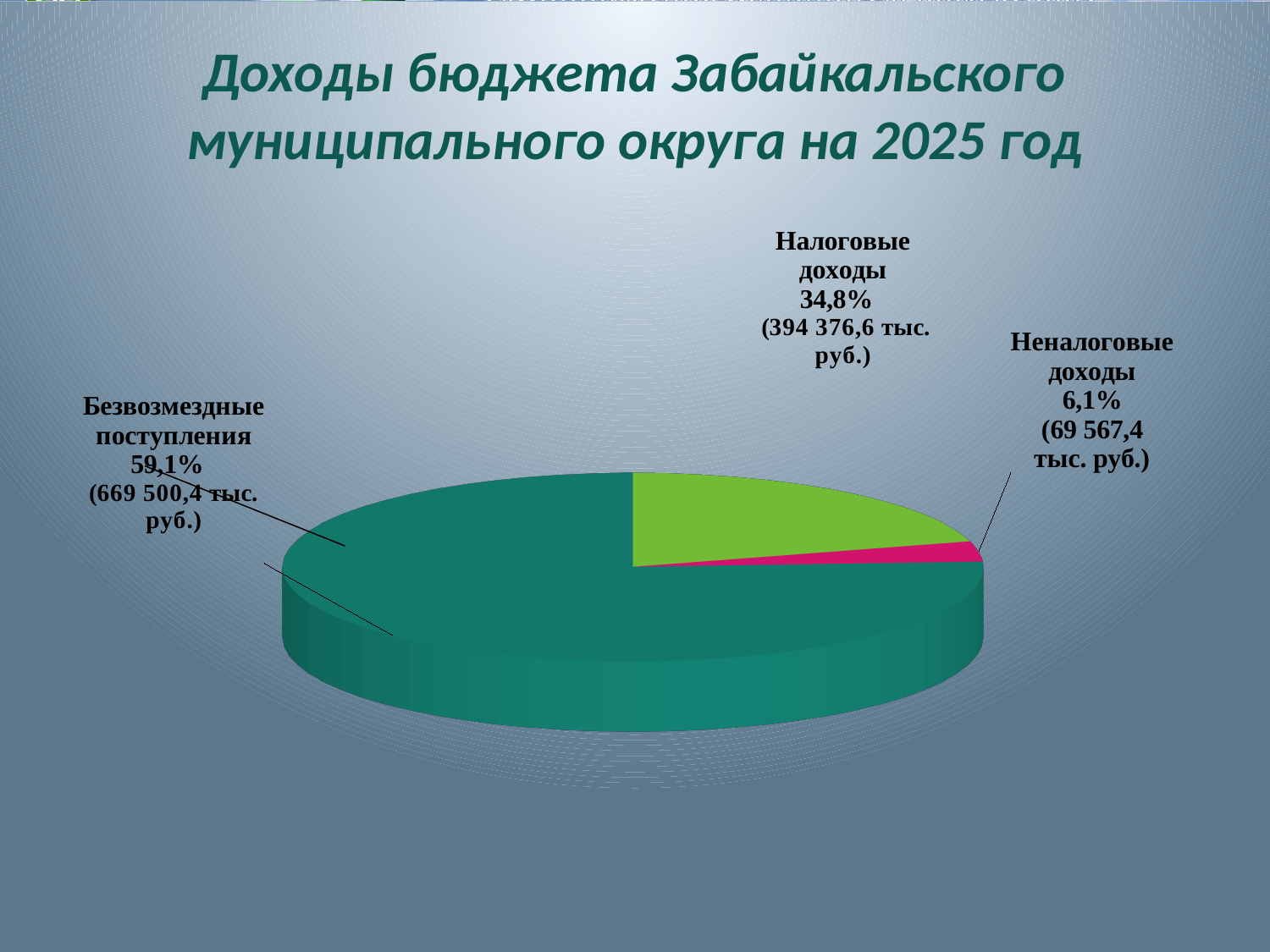
What share of the pie is Неналоговые доходы? 6,1% Which category has the smallest share of the pie? Неналоговые доходы What is the value in тыс. руб. for Безвозмездные поступления? 669 500,4 тыс. руб. What is the value in тыс. руб. for Налоговые доходы? 394 376,6 тыс. руб. What share of the pie is Безвозмездные поступления? 59,1% Which is larger: Налоговые доходы or Неналоговые доходы? Налоговые доходы What kind of chart is shown on the slide? Pie chart What share of the pie is Налоговые доходы? 34,8% How many slices does the pie chart have? 3 What is the value in тыс. руб. for Неналоговые доходы? 69 567,4 тыс. руб. By how many percentage points does the share of Безвозмездные поступления exceed that of Налоговые доходы? 24,3 Which category has the largest share of the pie? Безвозмездные поступления